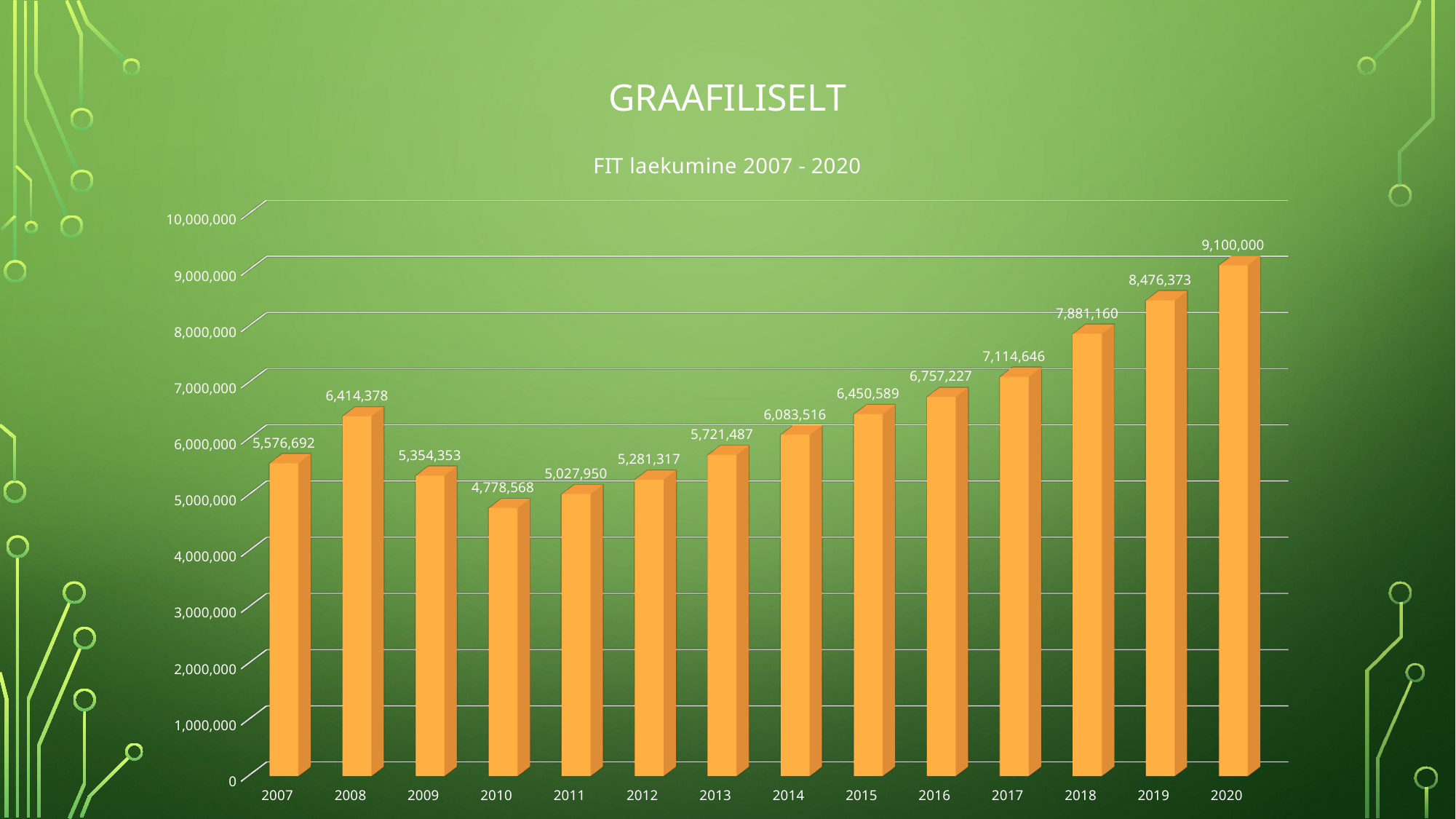
Which year has the lowest value? 2010 What is the difference between the values for 2020 and 2019? 623,627 How many years are shown on the x axis? 14 Do the values rise or fall from 2011 to 2020? rise What is the value for 2020? 9,100,000 What is the title of the chart? FIT laekumine 2007 - 2020 Is the value for 2018 greater or less than 7,000,000? greater What kind of chart is shown? bar chart What is the value for 2016? 6,757,227 Which year has the highest value? 2020 Which is larger, the value for 2008 or the value for 2009? 2008 What is the value for 2010? 4,778,568